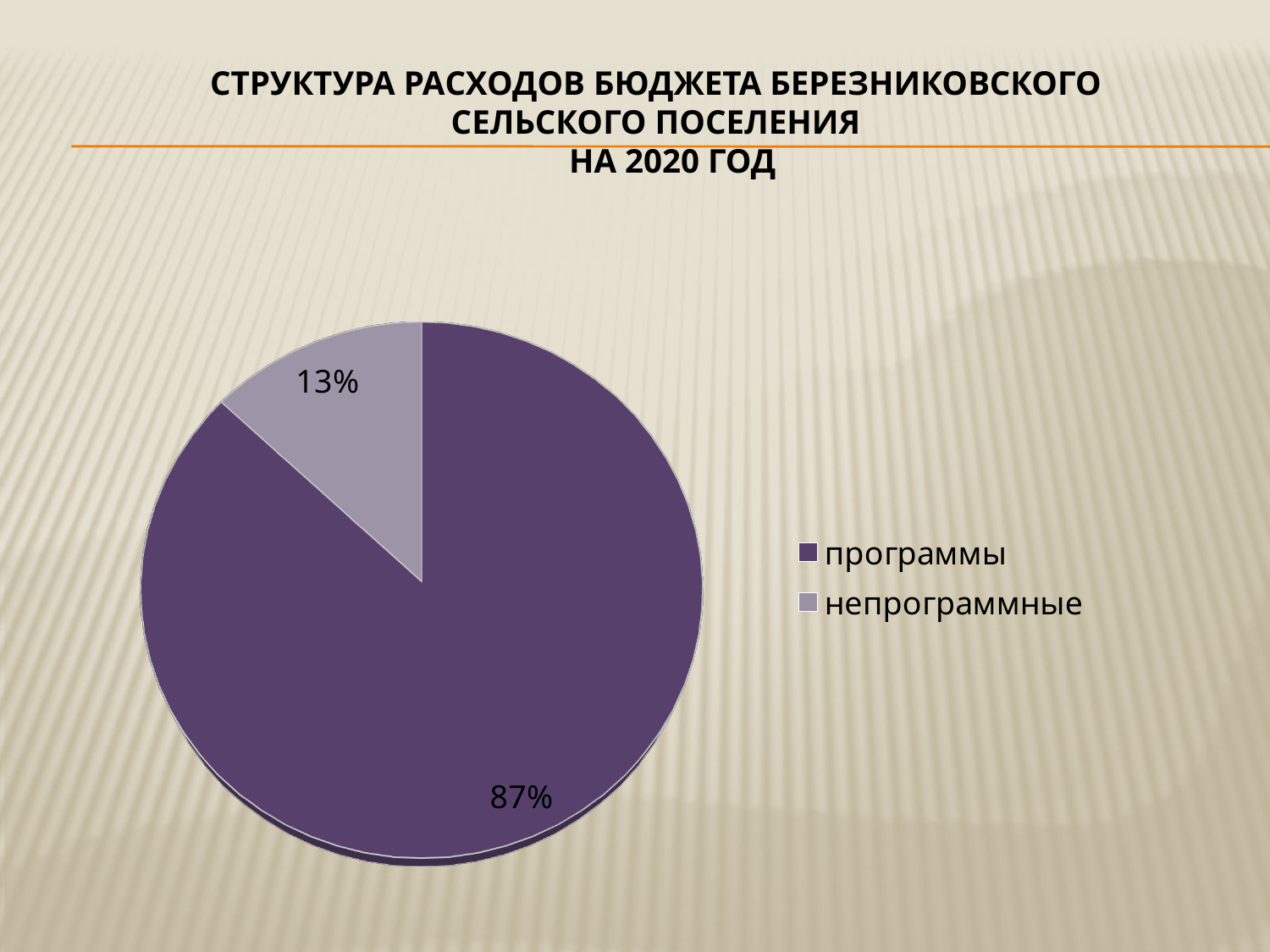
Which category has the largest slice of the pie? программы What is the difference in percentage points between the "программы" and "непрограммные" slices? 74 What share of the pie does the "непрограммные" slice represent? 13% How many slices does the pie chart have? 2 How many entries does the legend list? 2 Which category has the smallest slice of the pie? непрограммные Which is larger: the "программы" slice or the "непрограммные" slice? программы What share of the pie does the "программы" slice represent? 87% What is the title of the slide? Структура расходов бюджета Березниковского сельского поселения на 2020 год What kind of chart is shown on the slide? pie chart Which legend entry is shown in the lighter grey-purple colour? непрограммные